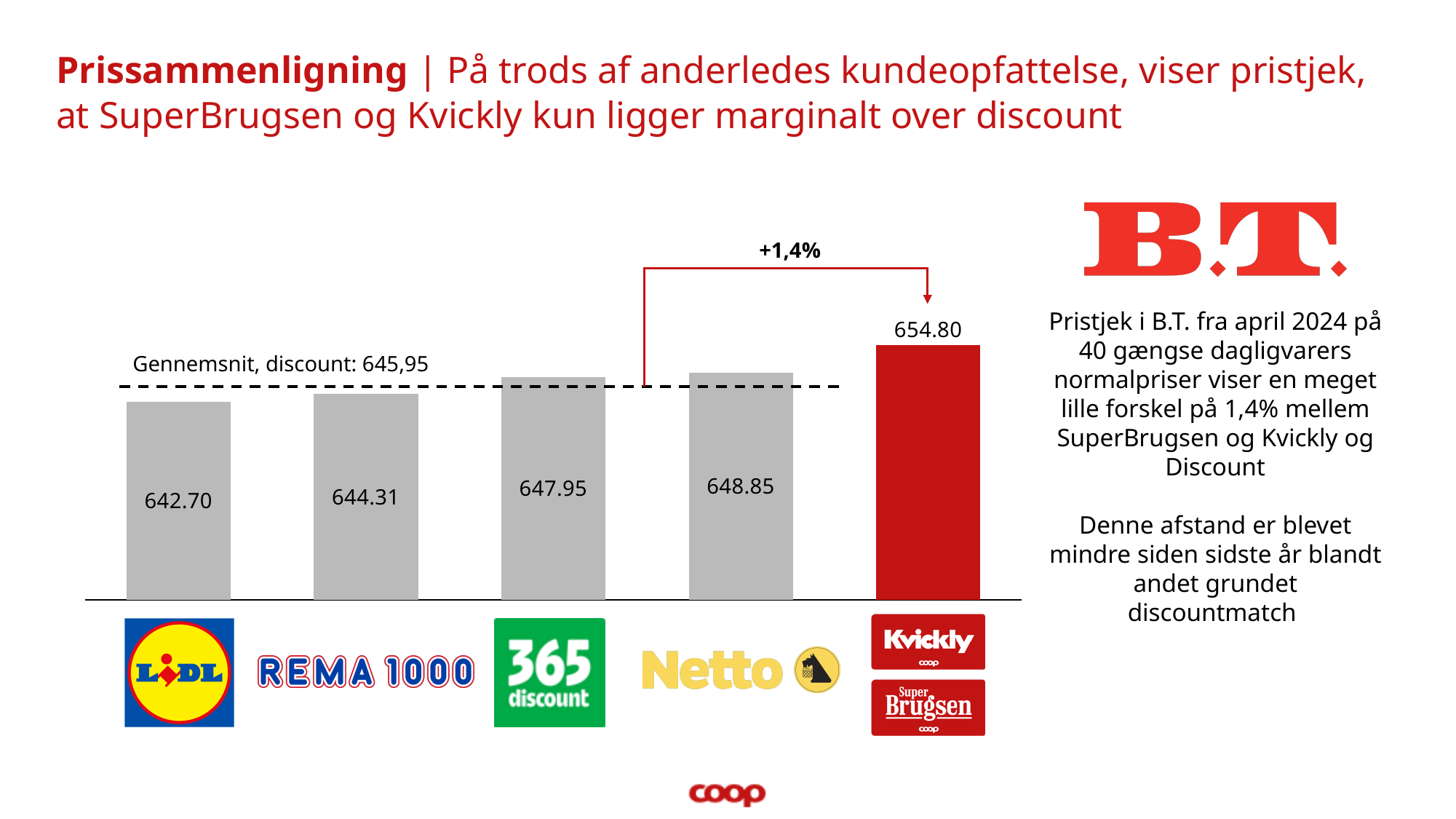
What is the value shown for Lidl? 642.70 Which is larger, the value for 365 discount or the value for REMA 1000? 365 discount Which store has the highest value in the chart? Kvickly / SuperBrugsen Which store has the lowest value in the chart? Lidl What value does the dashed line labelled 'Gennemsnit, discount' represent? 645,95 How many bars are shown in the chart? 5 What is the value shown for the red bar (Kvickly / SuperBrugsen)? 654.80 What is the value shown for REMA 1000? 644.31 What is the value shown for Netto? 648.85 What is the difference between the Netto value and the Lidl value? 6.15 What kind of chart is shown on the slide? Bar chart